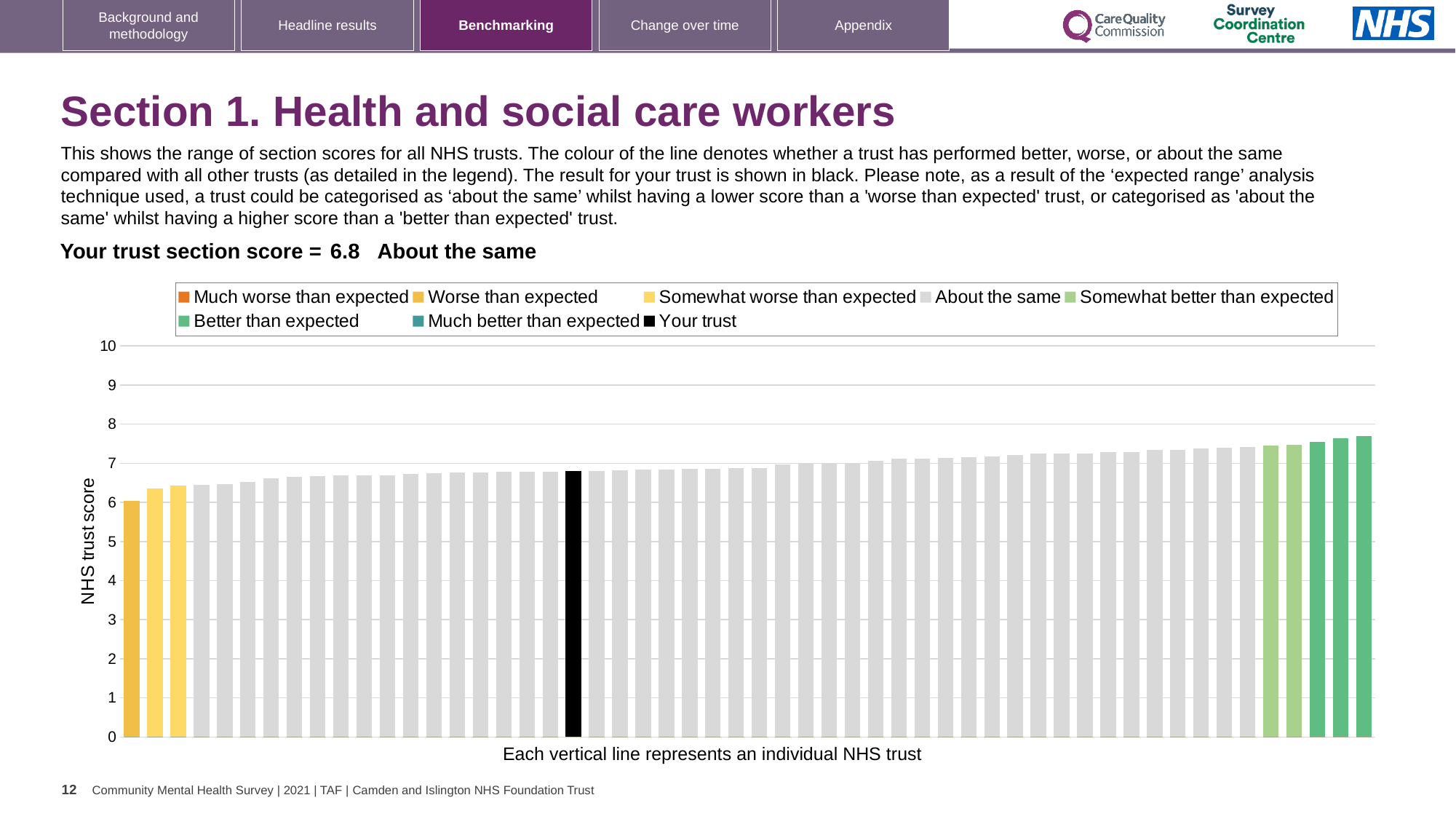
Which is larger: the value for your trust or the value of the leftmost bar? your trust What is the label on the vertical axis of the chart? NHS trust score What is the section score for your trust shown on the slide? 6.8 How many entries does the chart legend list? 8 Is the value of the highest bar (rightmost trust) greater or less than 8? less Is the value of the highest bar (rightmost trust) greater or less than 7? greater Is the value of the lowest bar (leftmost trust) greater or less than 7? less What colour is the bar representing your trust? black Which category is your trust's section score placed in? About the same How many bars are coloured yellow (somewhat worse than expected)? 2 Do the bar values rise or fall from left to right along the x axis? rise What kind of chart is shown on the slide? bar chart